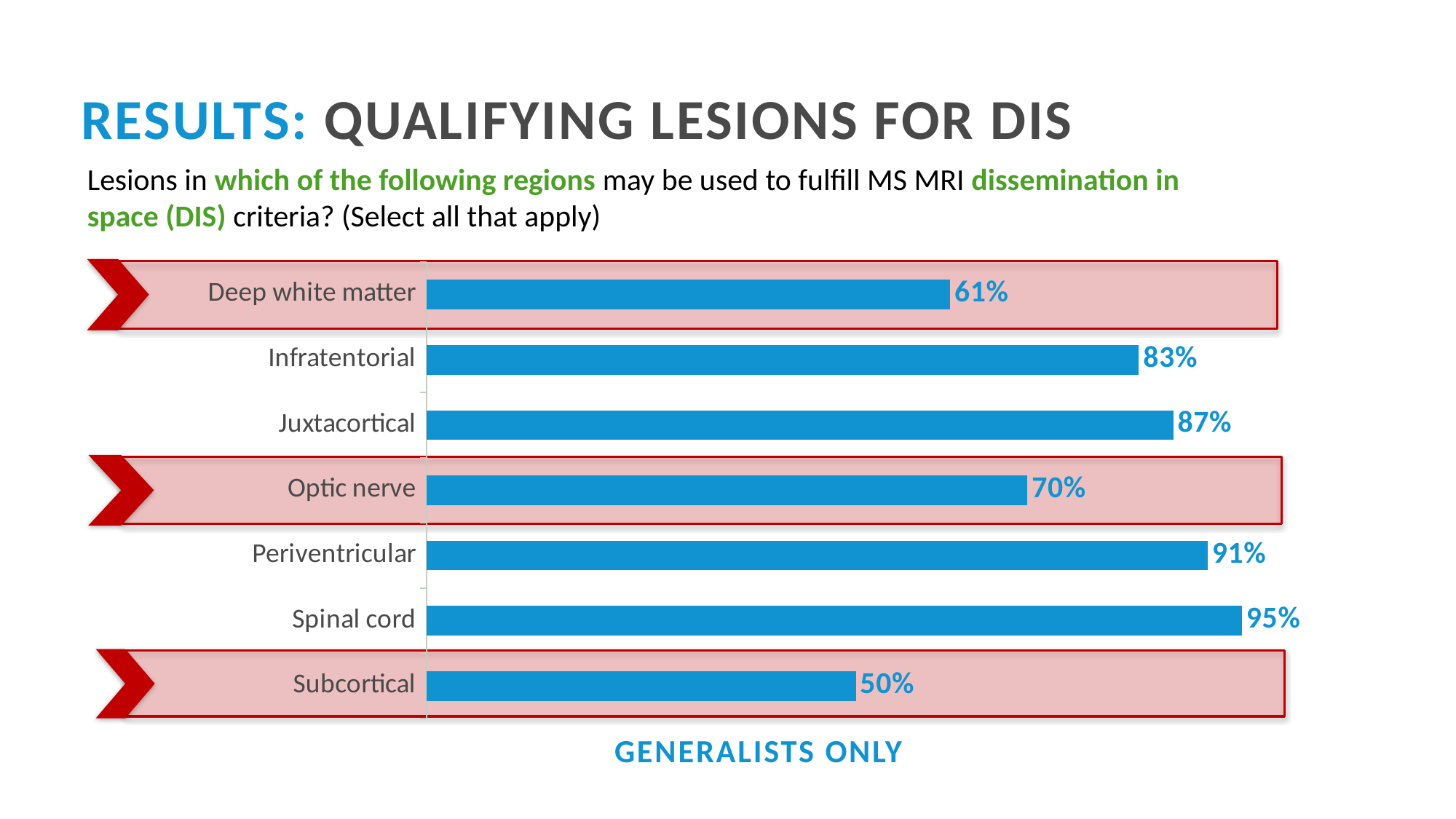
What percentage of generalists selected Deep white matter? 61% Which has a larger value, Optic nerve or Deep white matter? Optic nerve What percentage is shown for Optic nerve? 70% Which region has the lowest percentage? Subcortical What is the value shown for Infratentorial? 83% What is the difference between the values for Spinal cord and Subcortical? 45% Which region has the highest percentage? Spinal cord What is the difference between the values for Juxtacortical and Infratentorial? 4% What type of chart is shown on the slide? Bar chart Which respondent group does the chart represent, according to the label below it? Generalists only What is the value for Periventricular? 91% How many regions are shown in the chart? 7